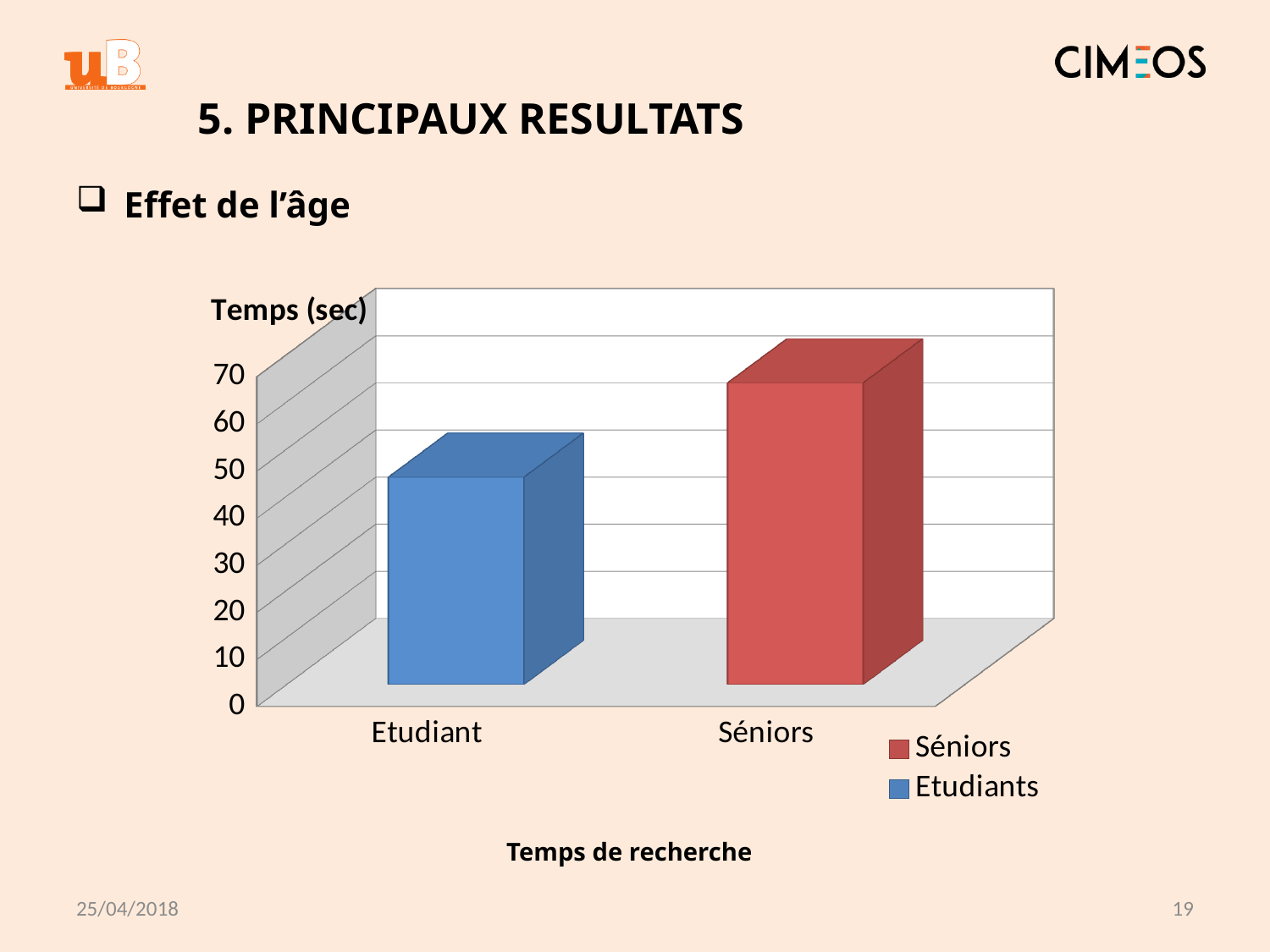
How many entries does the chart legend list? 2 What type of chart is shown on the slide? bar chart Which is larger, the value for Etudiant or the value for Séniors? Séniors Is the value for Séniors greater or less than 50? greater Which category has the highest search time in the chart? Séniors Is the value for Etudiant greater or less than 60? less Which category has the lowest search time in the chart? Etudiant What is the title of the chart? Temps de recherche Is the value for Etudiant greater or less than 30? greater How many categories are shown on the x axis of the chart? 2 What unit is indicated on the vertical axis label of the chart? sec